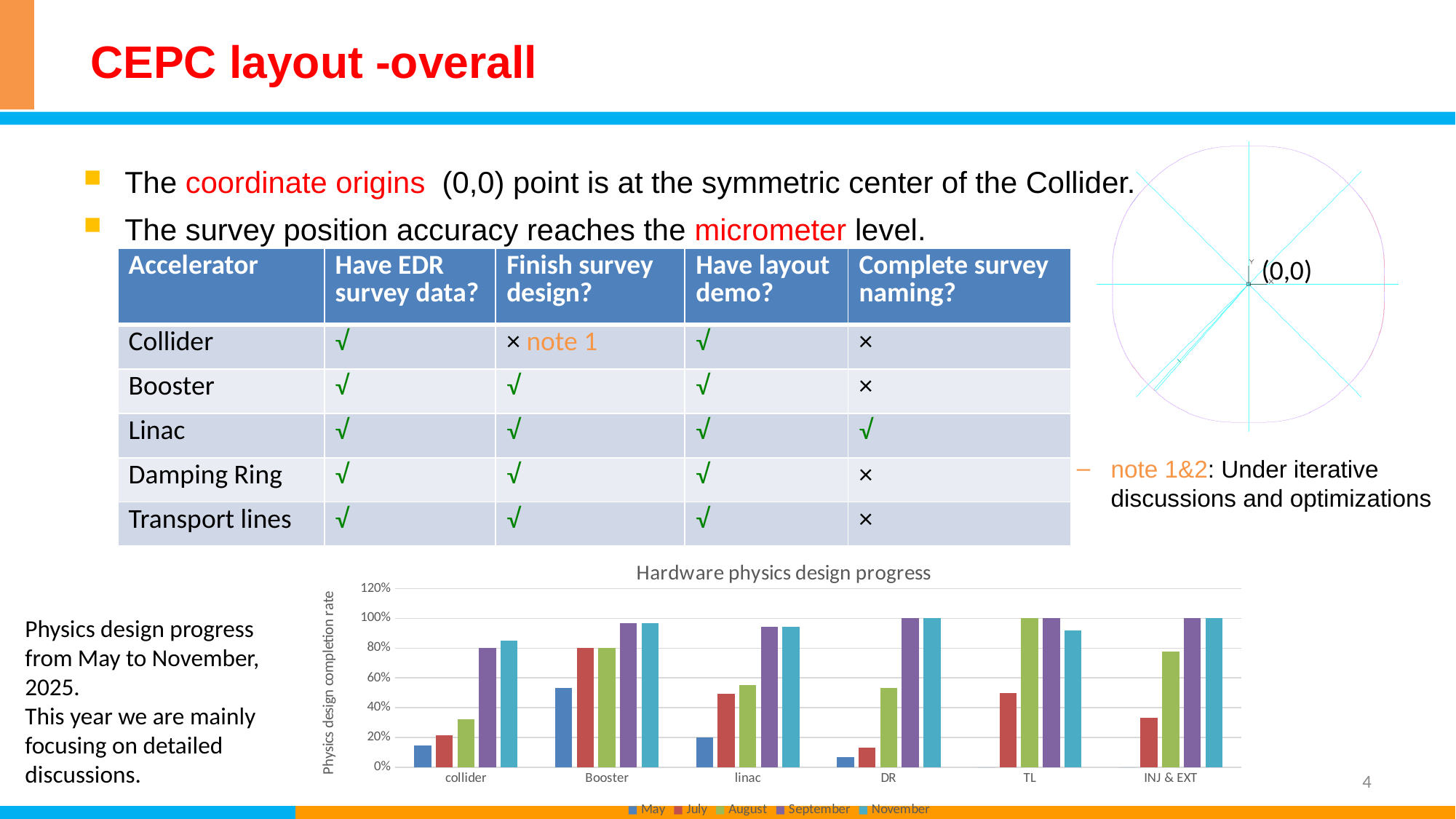
In the 'Hardware physics design progress' chart, is the May value for Booster greater or less than 40%? greater How many series does the legend of the 'Hardware physics design progress' chart list? 5 In the 'Hardware physics design progress' chart, which category has the lowest November value? collider In the 'Hardware physics design progress' chart, which category has the highest May value? Booster What is the y-axis label of the 'Hardware physics design progress' chart? Physics design completion rate In the 'Hardware physics design progress' chart, do the collider values rise or fall from May to November? rise In the 'Hardware physics design progress' chart, which is larger: the July value for DR or the July value for TL? TL In the 'Hardware physics design progress' chart, is the November value for linac greater or less than 80%? greater How many categories are shown on the x axis of the 'Hardware physics design progress' chart? 6 In the 'Hardware physics design progress' chart, is the May value for collider greater or less than 20%? less What type of chart is the 'Hardware physics design progress' chart? bar chart